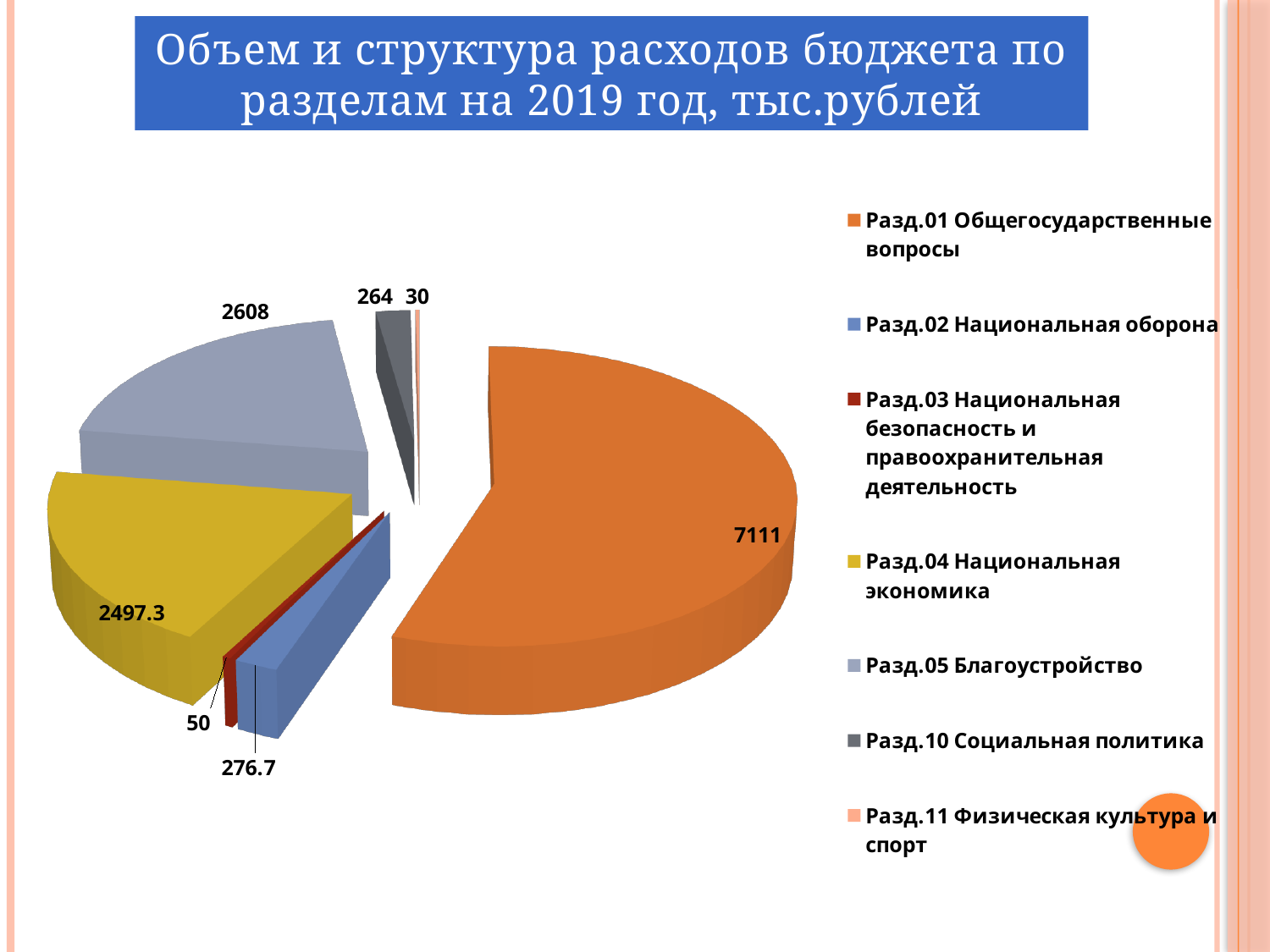
What is the value for Разд.05 Благоустройство? 2608 What is the value for Разд.01 Общегосударственные вопросы? 7111 How many sections (slices) does the pie chart show? 7 Which section has the largest share of the budget expenses? Разд.01 Общегосударственные вопросы What kind of chart is shown on the slide? Pie chart What is the value for Разд.11 Физическая культура и спорт? 30 Which section has the smallest value? Разд.11 Физическая культура и спорт What is the value for Разд.02 Национальная оборона? 276.7 What is the title of the chart on the slide? Объем и структура расходов бюджета по разделам на 2019 год, тыс.рублей What is the value for Разд.04 Национальная экономика? 2497.3 Which is larger: Разд.02 Национальная оборона or Разд.10 Социальная политика? Разд.02 Национальная оборона What is the difference between the values for Разд.05 Благоустройство and Разд.04 Национальная экономика? 110.7